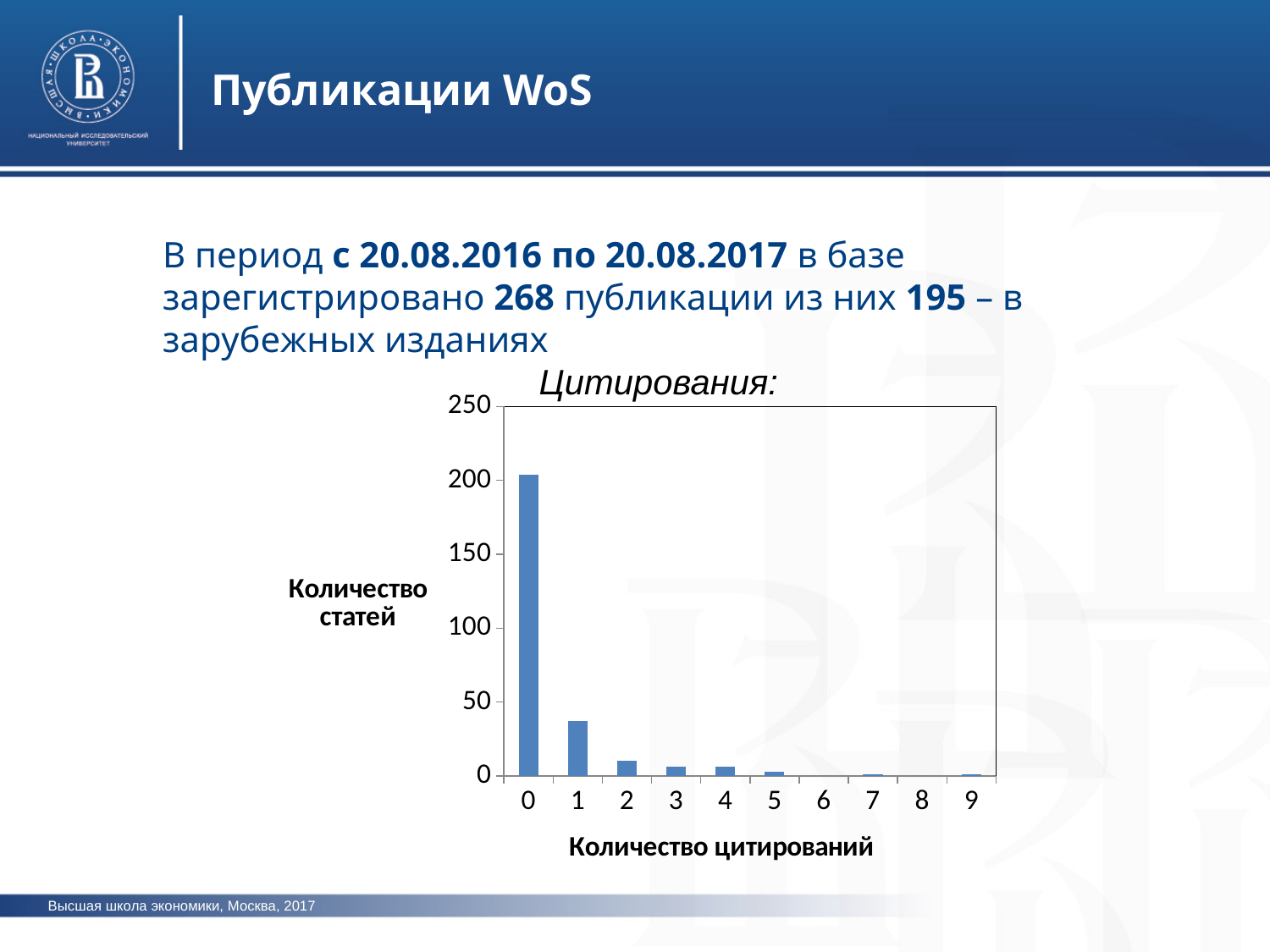
Do the values generally rise or fall as the number of citations increases along the x axis? fall What kind of chart is shown on the slide? bar chart How many categories are shown on the x axis of the chart? 10 Is the value for 0 citations greater or less than 250? less Which has more articles: 1 citation or 2 citations? 1 What is the title of the chart? Цитирования: Is the value for 1 citation greater or less than 50? less Is the value for 0 citations greater or less than 200? greater What is the label of the x axis of the chart? Количество цитирований Which has more articles: 0 citations or 1 citation? 0 Which number of citations has the highest number of articles? 0